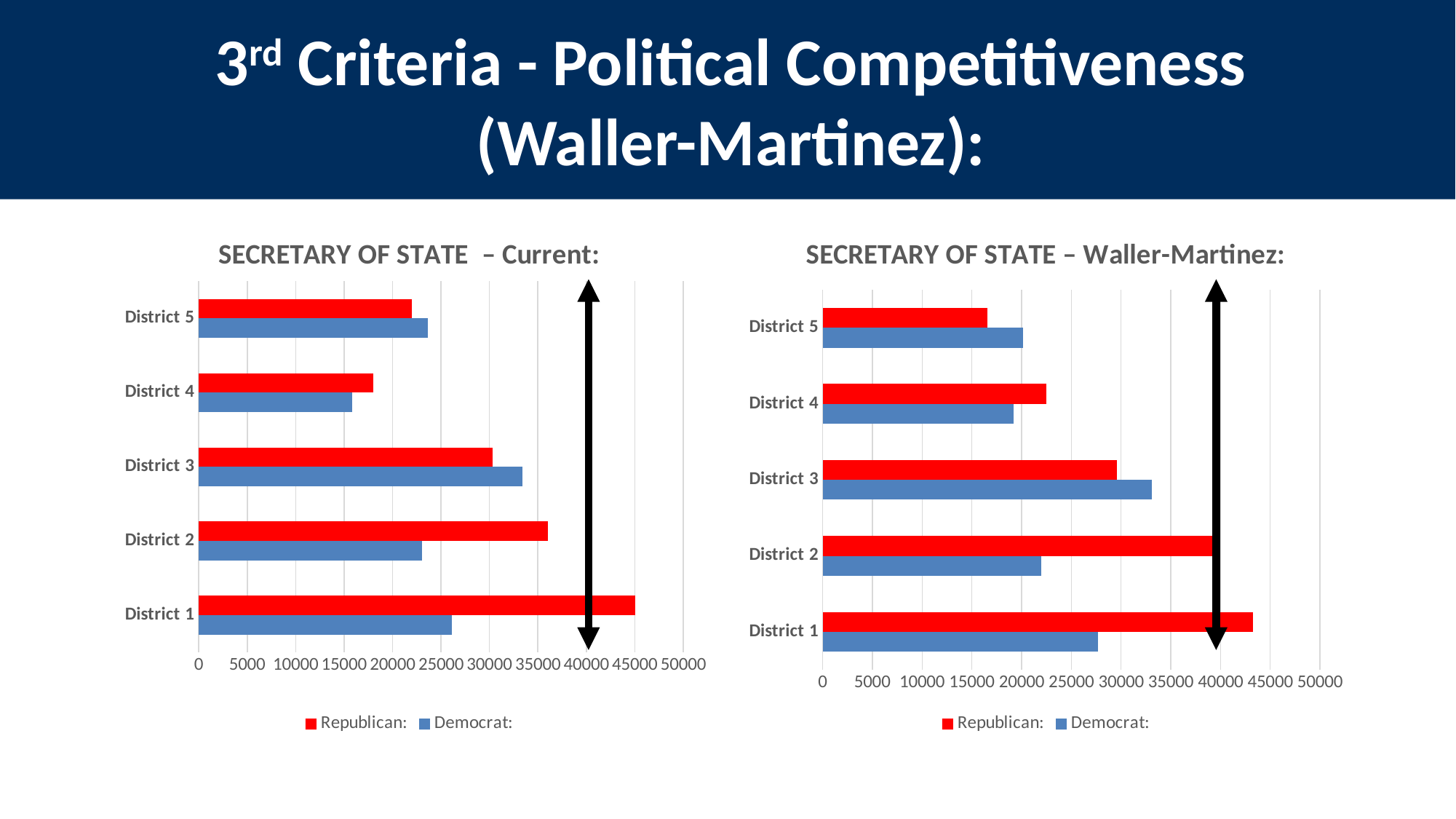
In the SECRETARY OF STATE – Current chart, for District 2, which is larger: the Republican or the Democrat value? Republican What kind of chart is the SECRETARY OF STATE – Current chart? bar chart How many series does the legend of the SECRETARY OF STATE – Current chart list? 2 In the SECRETARY OF STATE – Waller-Martinez chart, for District 3, which is larger: the Republican or the Democrat value? Democrat In the SECRETARY OF STATE – Waller-Martinez chart, which district has the highest Democrat value? District 3 In the SECRETARY OF STATE – Current chart, which district has the highest Republican value? District 1 In the SECRETARY OF STATE – Current chart, is the Republican value for District 1 greater or less than 40000? greater In the SECRETARY OF STATE – Current chart, is the Democrat value for District 4 greater or less than 20000? less How many districts are shown in the SECRETARY OF STATE – Waller-Martinez chart? 5 In the SECRETARY OF STATE – Waller-Martinez chart, is the Republican value for District 2 greater or less than 35000? greater In the SECRETARY OF STATE – Current chart, which district has the lowest Republican value? District 4 In the SECRETARY OF STATE – Waller-Martinez chart, which district has the lowest Republican value? District 5